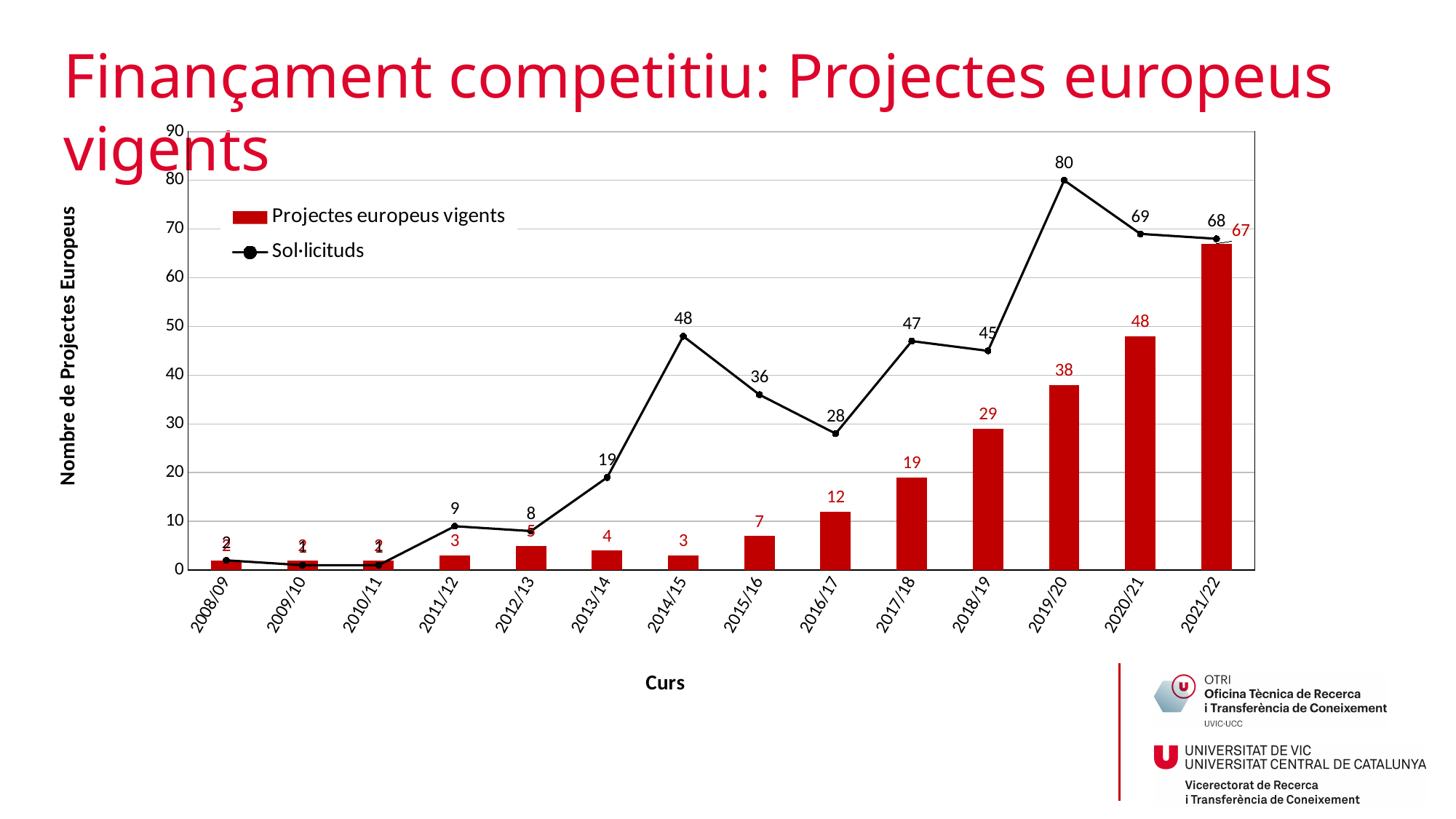
Which is larger in 2016/17: Sol·licituds or Projectes europeus vigents? Sol·licituds What is the difference between Sol·licituds and Projectes europeus vigents in 2019/20? 42 What is the value of Projectes europeus vigents for 2021/22? 67 What is the value of Projectes europeus vigents for 2017/18? 19 How many series does the legend list? 2 How many Sol·licituds were there in 2014/15? 48 Do the Projectes europeus vigents bars generally rise or fall from 2014/15 to 2021/22? Rise How many academic years (Curs) are shown on the x axis? 14 What kind of chart is shown on the slide? Combined bar and line chart In which year is the Sol·licituds line at its highest? 2019/20 How many Sol·licituds were there in 2019/20? 80 In which year is the Projectes europeus vigents bar the tallest? 2021/22